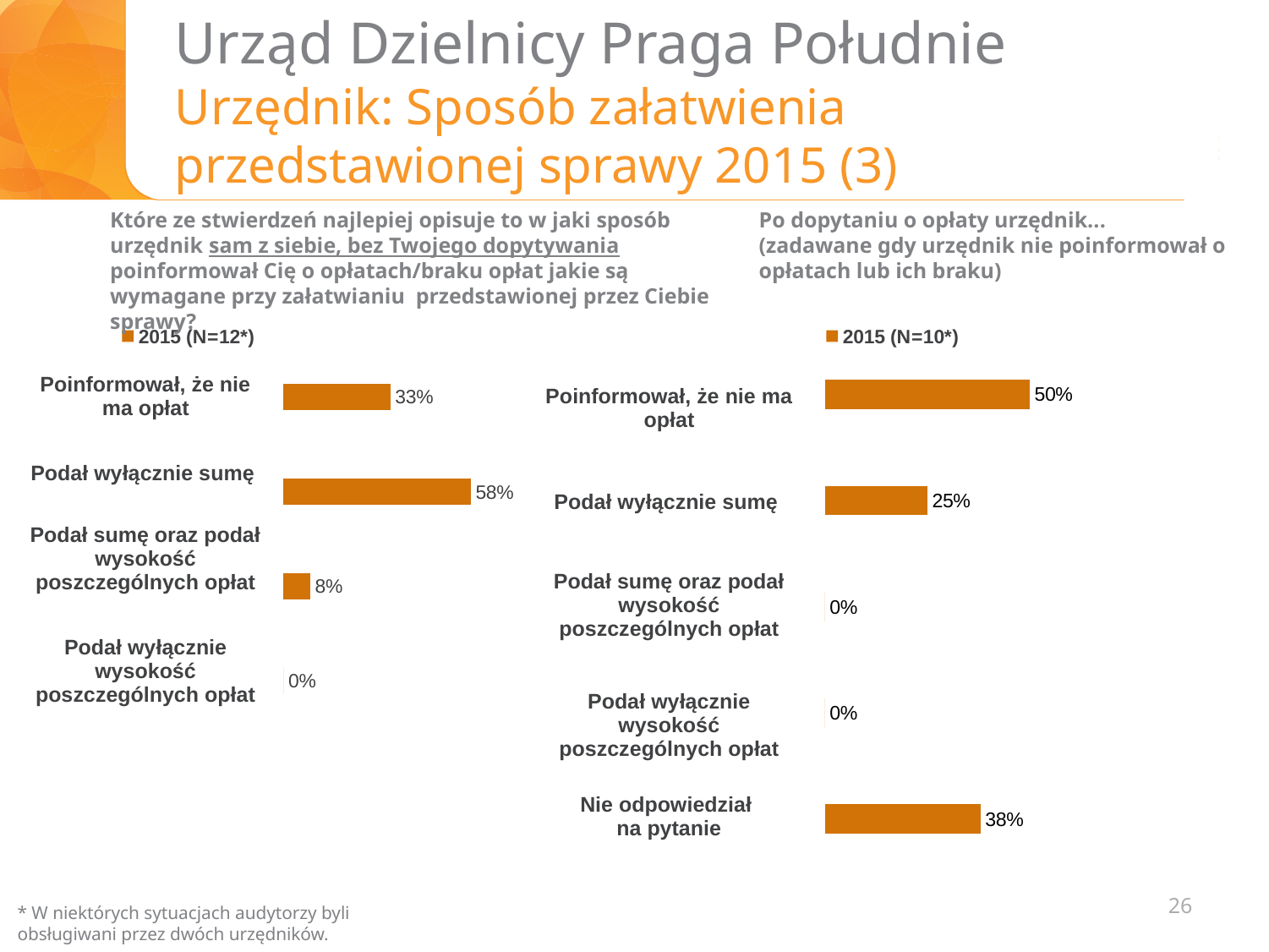
In the left chart, what is the difference between "Podał wyłącznie sumę" and "Poinformował, że nie ma opłat"? 25 percentage points In the left chart, which category has the highest value? Podał wyłącznie sumę What type of chart is the left chart? Bar chart In the right chart, which is larger: "Podał wyłącznie sumę" or "Nie odpowiedział na pytanie"? Nie odpowiedział na pytanie In the right chart, what is the value for "Nie odpowiedział na pytanie"? 38% In the right chart, what is the value for "Podał wyłącznie sumę"? 25% How many categories does the right chart show? 5 How many categories does the left chart show? 4 In the left chart, what is the value for "Podał wyłącznie sumę"? 58% In the right chart, what is the difference between "Poinformował, że nie ma opłat" and "Nie odpowiedział na pytanie"? 12 percentage points In the right chart, which category has the highest value? Poinformował, że nie ma opłat In the left chart, what is the value for "Poinformował, że nie ma opłat"? 33%